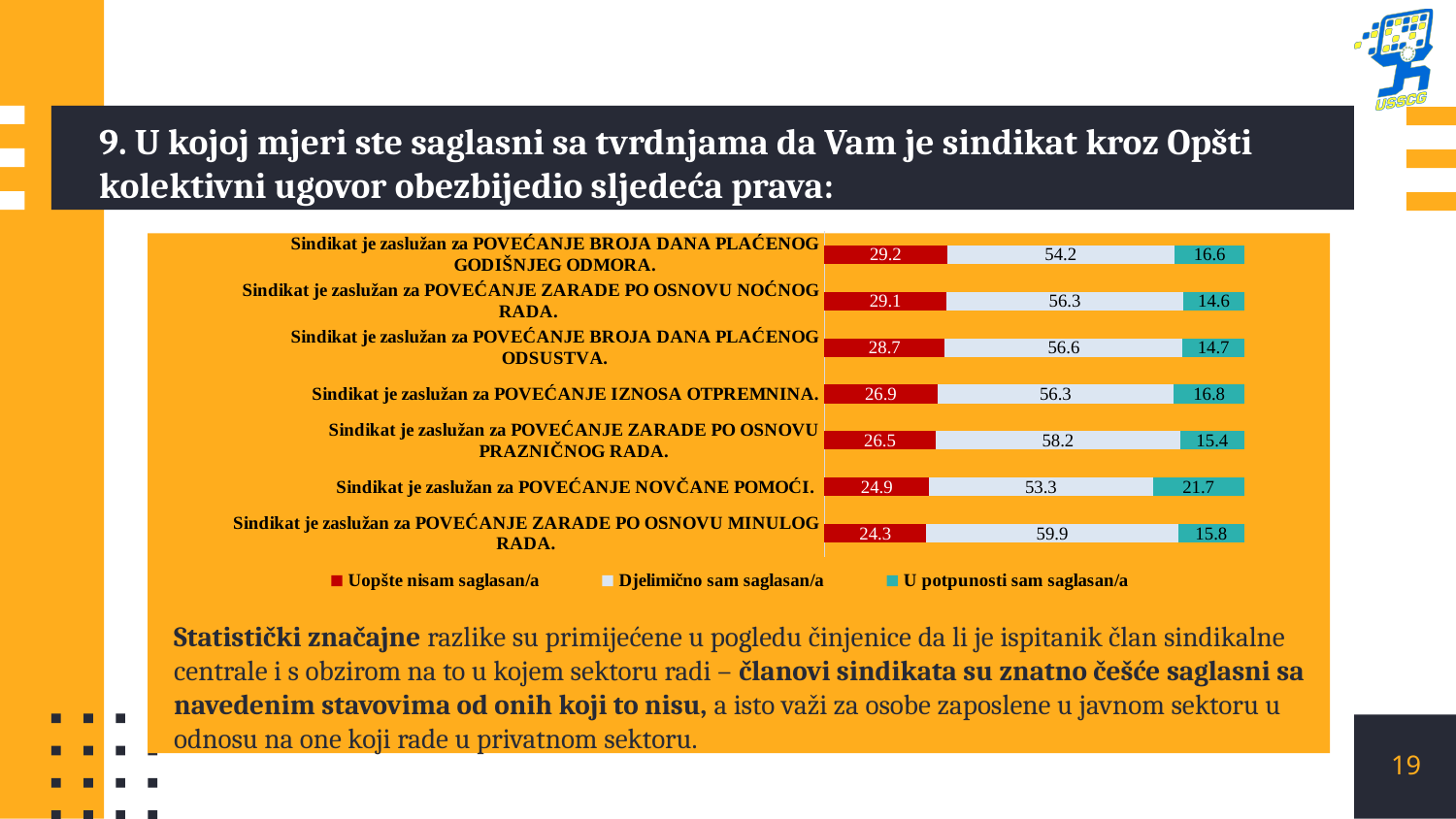
Which statement has the lowest value for 'Uopšte nisam saglasan/a'? Sindikat je zaslužan za POVEĆANJE ZARADE PO OSNOVU MINULOG RADA Which statement has the highest value for 'U potpunosti sam saglasan/a'? Sindikat je zaslužan za POVEĆANJE NOVČANE POMOĆI What is the value of 'U potpunosti sam saglasan/a' for 'Sindikat je zaslužan za POVEĆANJE IZNOSA OTPREMNINA'? 16.8 What is the value of 'Uopšte nisam saglasan/a' for 'Sindikat je zaslužan za POVEĆANJE NOVČANE POMOĆI'? 24.9 Which colour represents 'Uopšte nisam saglasan/a' in the chart? Red What kind of chart is shown on the slide? Stacked bar chart What is the total of the stacked bar for 'Sindikat je zaslužan za POVEĆANJE ZARADE PO OSNOVU NOĆNOG RADA'? 100.0 What is the value of 'Djelimično sam saglasan/a' for 'Sindikat je zaslužan za POVEĆANJE ZARADE PO OSNOVU MINULOG RADA'? 59.9 Which is larger: the 'Uopšte nisam saglasan/a' value for 'POVEĆANJE BROJA DANA PLAĆENOG GODIŠNJEG ODMORA' or for 'POVEĆANJE ZARADE PO OSNOVU PRAZNIČNOG RADA'? POVEĆANJE BROJA DANA PLAĆENOG GODIŠNJEG ODMORA What is the difference between the 'Djelimično sam saglasan/a' values for 'POVEĆANJE ZARADE PO OSNOVU MINULOG RADA' and 'POVEĆANJE NOVČANE POMOĆI'? 6.6 How many categories (statements) are plotted in the chart? 7 How many series does the legend list? 3